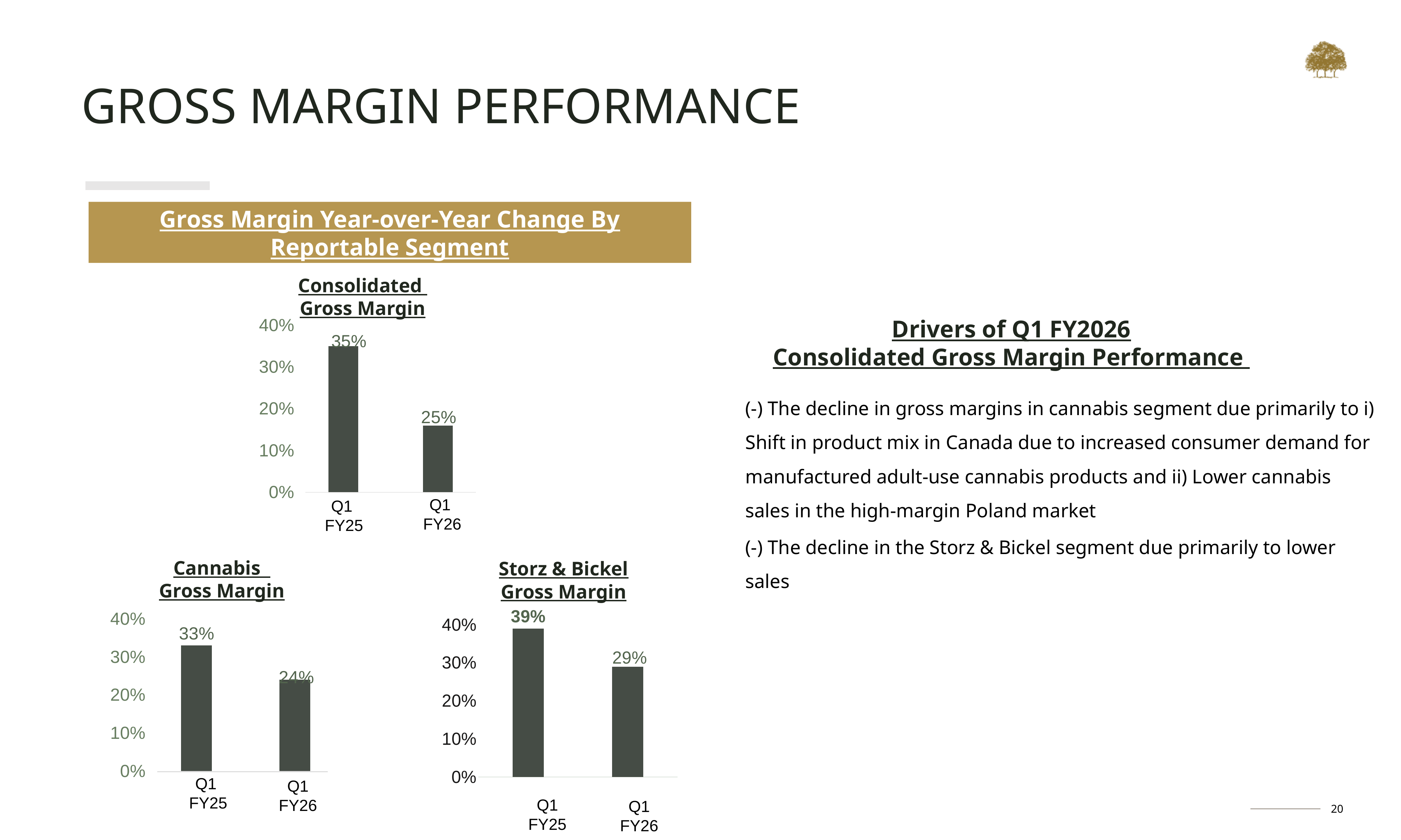
In the Storz & Bickel Gross Margin chart, which period has the higher value, Q1 FY25 or Q1 FY26? Q1 FY25 In the Cannabis Gross Margin chart, do the values rise or fall from Q1 FY25 to Q1 FY26? fall In the Consolidated Gross Margin chart, what is the value for Q1 FY25? 35% In the Storz & Bickel Gross Margin chart, what is the value for Q1 FY25? 39% In the Cannabis Gross Margin chart, what is the value for Q1 FY26? 24% In the Cannabis Gross Margin chart, what is the difference between the Q1 FY25 and Q1 FY26 values? 9% In the Consolidated Gross Margin chart, what is the difference between the Q1 FY25 and Q1 FY26 values? 10% How many bars are shown in the Consolidated Gross Margin chart? 2 What kind of chart is the Storz & Bickel Gross Margin chart? bar chart In the Cannabis Gross Margin chart, what is the value for Q1 FY25? 33% In the Storz & Bickel Gross Margin chart, what is the value for Q1 FY26? 29% In the Consolidated Gross Margin chart, what is the value for Q1 FY26? 25%